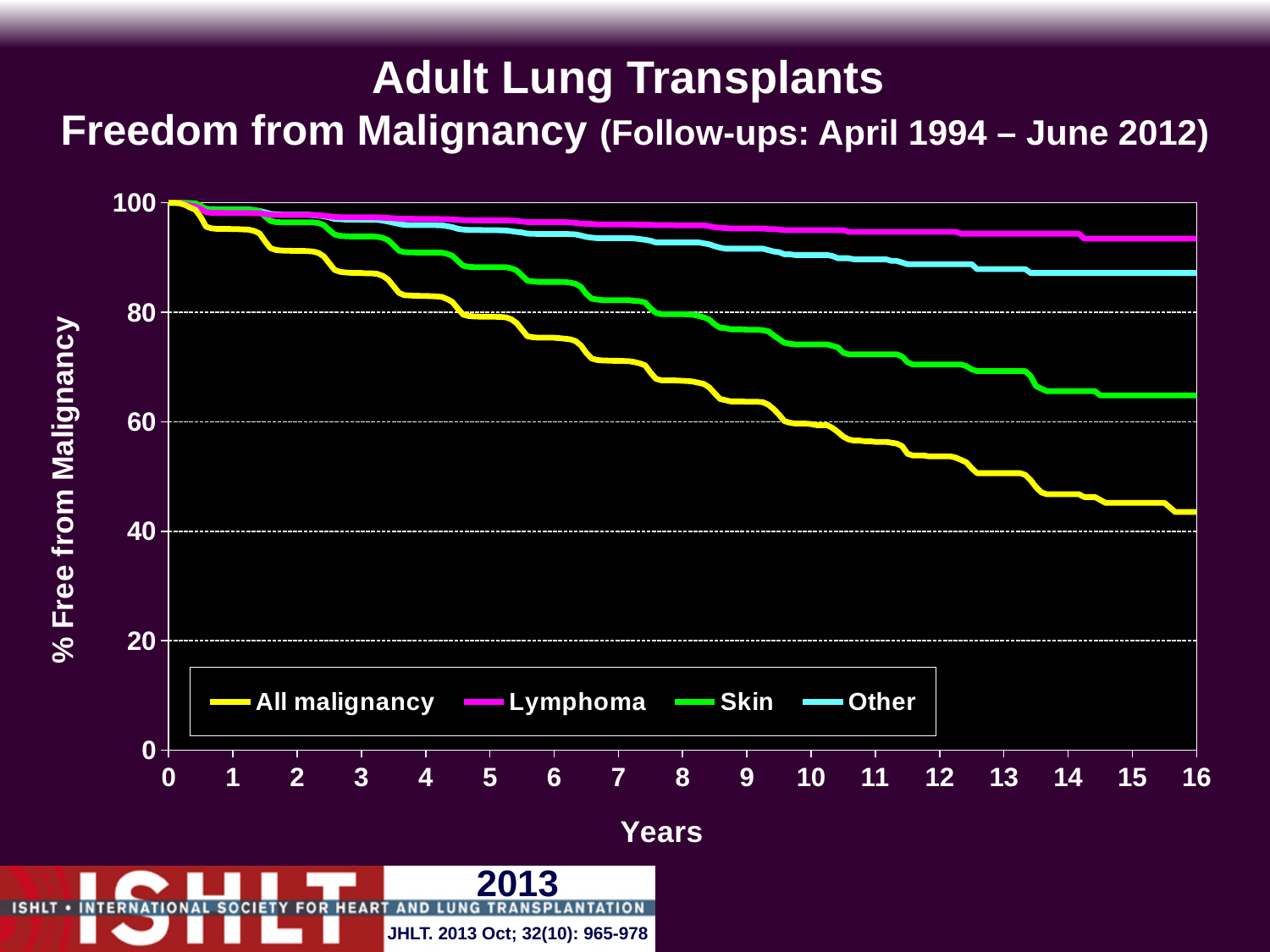
Which series has the lowest value at 16 years? All malignancy Is the value for Skin at 16 years greater or less than 60? greater What kind of chart is shown on the slide? line chart Which series are listed in the legend? All malignancy, Lymphoma, Skin, Other Which series has the highest value at 16 years? Lymphoma How many series does the legend list? 4 At 16 years, which is larger: the value for Skin or the value for Other? Other Is the value for All malignancy at 16 years greater or less than 40? greater Is the value for All malignancy at 16 years greater or less than 60? less Does the All malignancy curve rise or fall as the years increase? fall What is the label of the x axis? Years